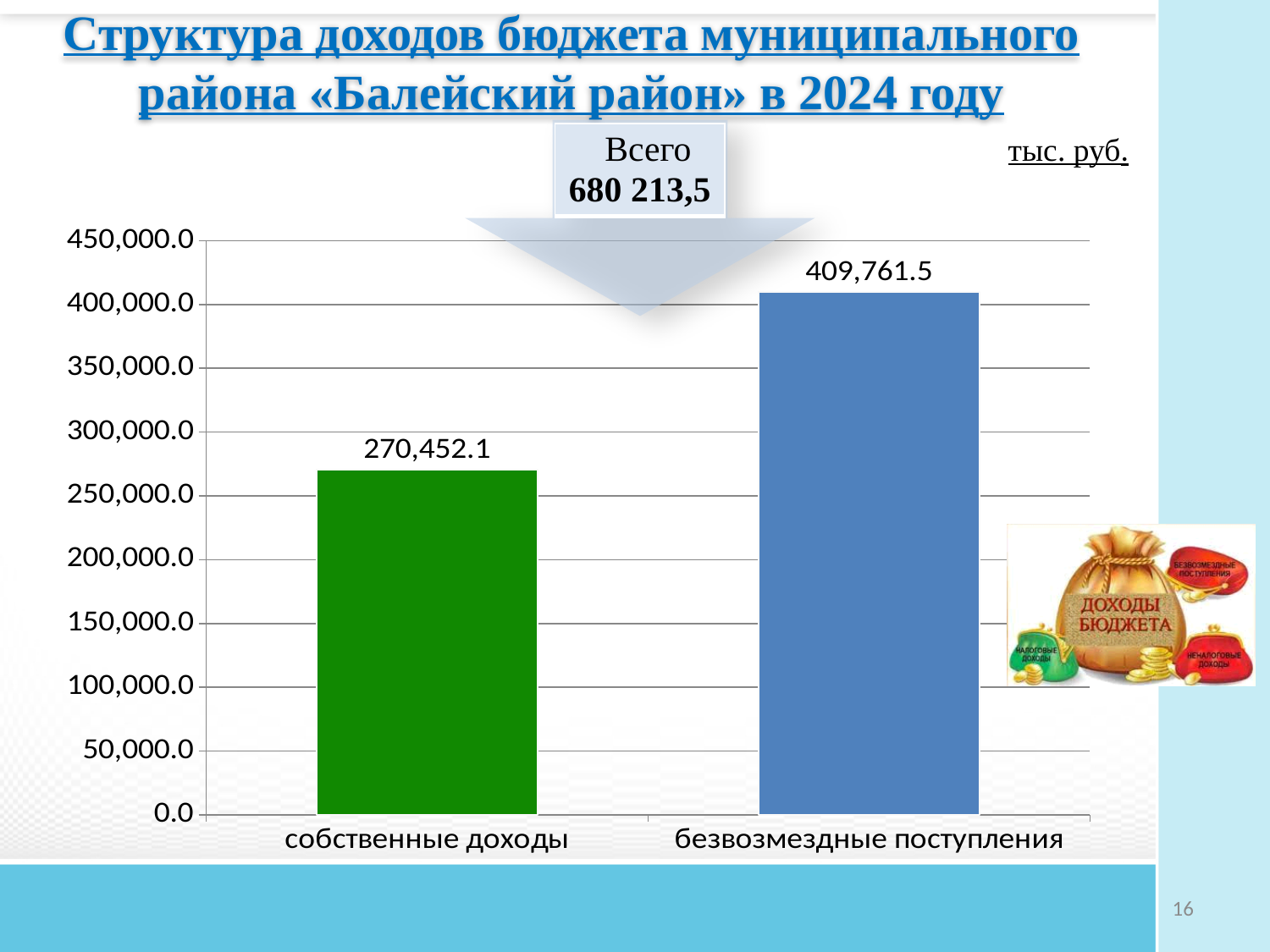
What colour is the bar for собственные доходы? green What kind of chart is shown on the slide? bar chart What is the value for безвозмездные поступления? 409,761.5 What total (Всего) is shown above the chart? 680 213,5 What is the value for собственные доходы? 270,452.1 Which is larger, собственные доходы or безвозмездные поступления? безвозмездные поступления Which category has the highest value? безвозмездные поступления How many categories are shown on the chart? 2 Is the value for безвозмездные поступления greater or less than 400,000.0? greater Is the value for собственные доходы greater or less than 300,000.0? less What is the difference between безвозмездные поступления and собственные доходы? 139,309.4 Which category has the lowest value? собственные доходы